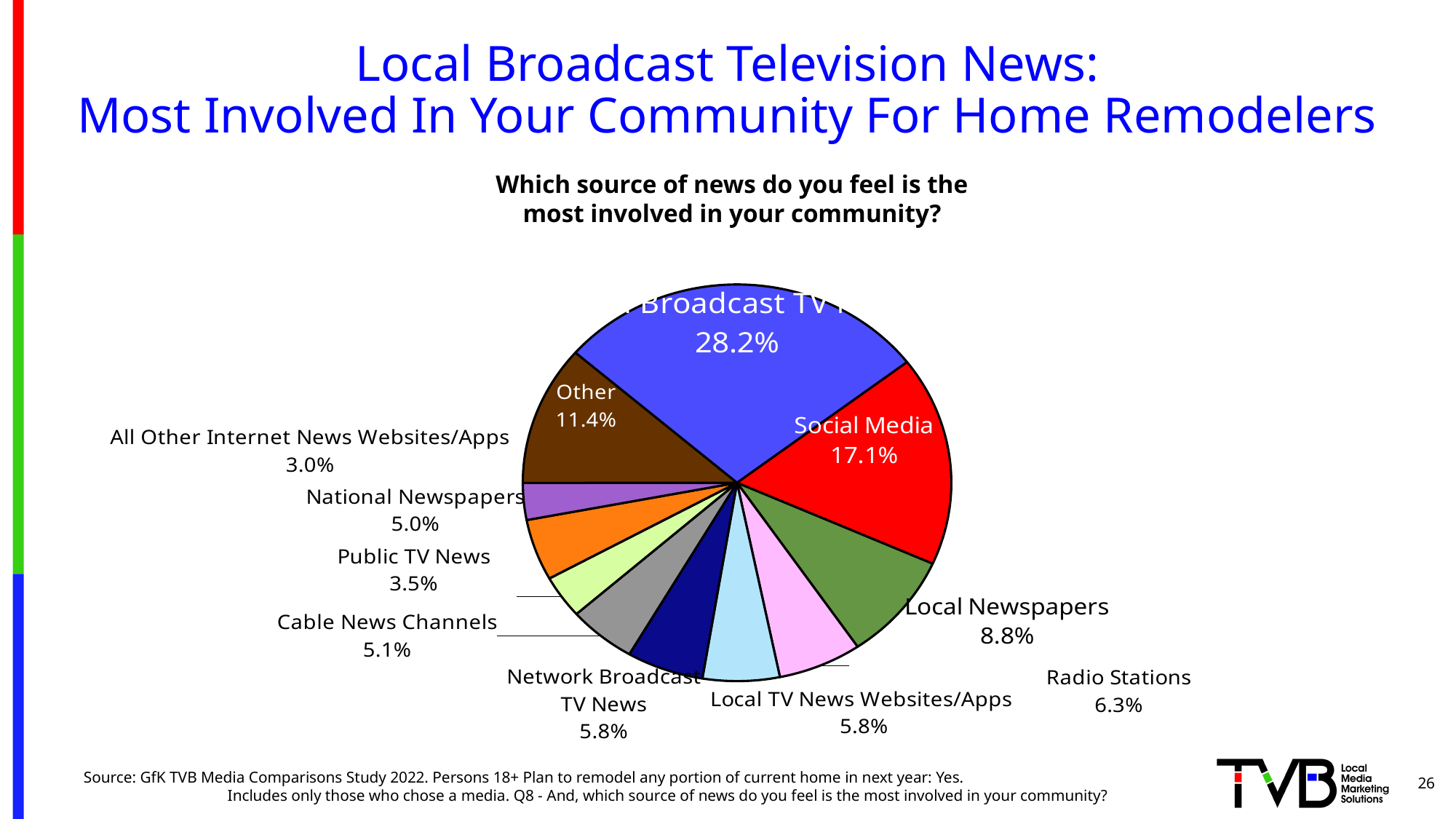
What percentage does the largest slice of the pie show? 28.2% How many slices does the pie chart have? 11 What is the difference between the Social Media share and the Local Newspapers share? 8.3% What percentage is shown for Radio Stations? 6.3% What kind of chart is shown on the slide? pie chart What value is shown for the Other slice? 11.4% What question is posed above the pie chart? Which source of news do you feel is the most involved in your community? Which is larger, the share for National Newspapers or the share for Public TV News? National Newspapers What percentage is shown for Cable News Channels? 5.1% What percentage of respondents chose Social Media as the news source most involved in their community? 17.1% Which category has the smallest slice of the pie? All Other Internet News Websites/Apps What share is shown for Local Newspapers? 8.8%